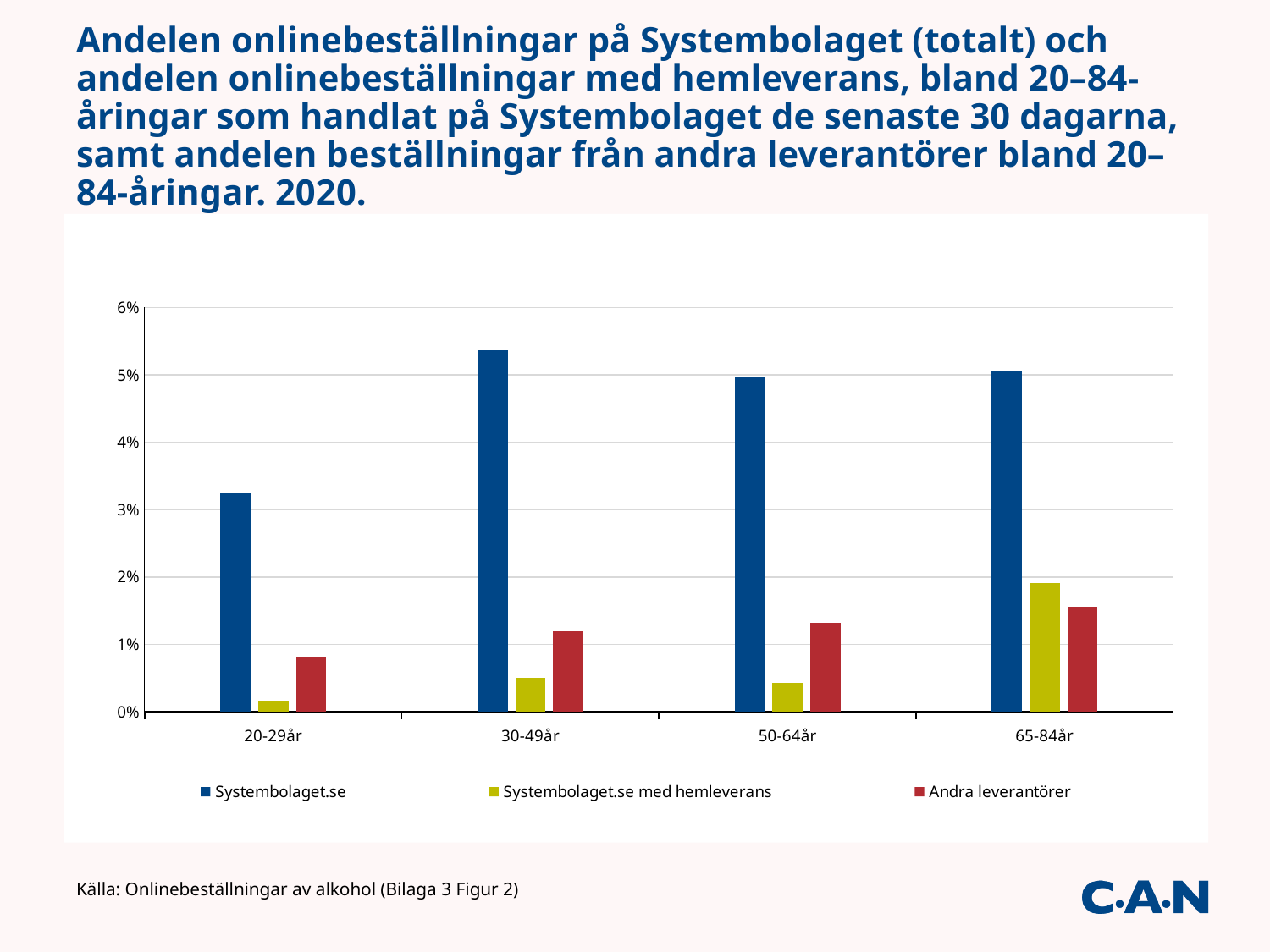
In the 65-84år group, which is larger: Systembolaget.se med hemleverans or Andra leverantörer? Systembolaget.se med hemleverans Which age group has the lowest value for Andra leverantörer? 20-29år How many age groups are shown on the x axis? 4 Which age group has the lowest value for Systembolaget.se? 20-29år Which age group has the highest value for Systembolaget.se med hemleverans? 65-84år What kind of chart is shown on the slide? Bar chart How many series does the legend list? 3 Is the value for Systembolaget.se in the 20-29år group greater or less than 3%? greater Is the value for Andra leverantörer in the 20-29år group greater or less than 1%? less Do the values for Andra leverantörer rise or fall from the youngest to the oldest age group? Rise Which age group has the highest value for Systembolaget.se? 30-49år Is the value for Systembolaget.se med hemleverans in the 65-84år group greater or less than 2%? less